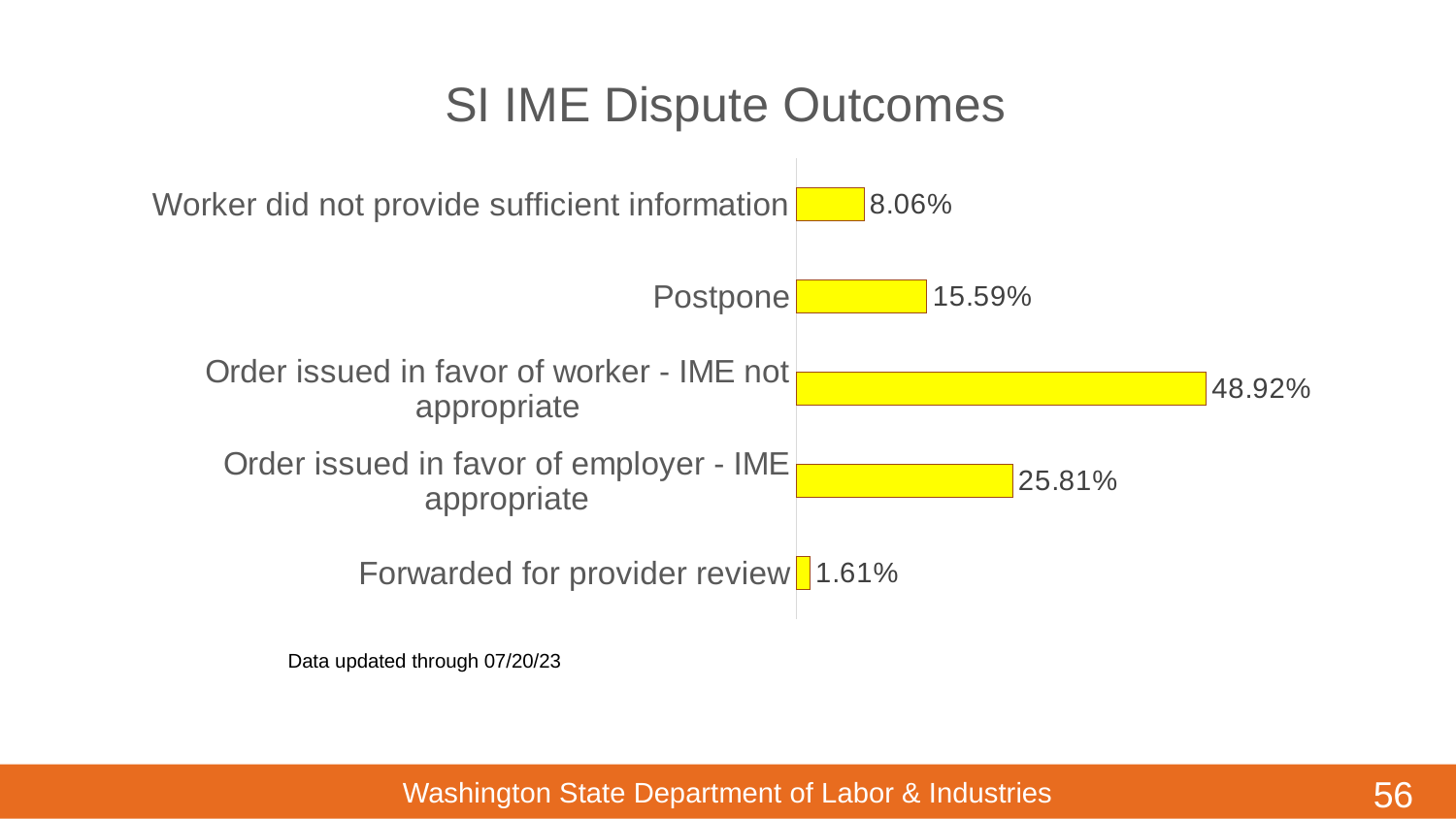
Which category has the lowest value? Forwarded for provider review What is the difference between "Order issued in favor of worker - IME not appropriate" and "Order issued in favor of employer - IME appropriate"? 23.11% Which is larger: "Postpone" or "Worker did not provide sufficient information"? Postpone What kind of chart is shown on the slide? Bar chart Which category has the highest value? Order issued in favor of worker - IME not appropriate What is the value for "Worker did not provide sufficient information"? 8.06% What is the value for "Postpone"? 15.59% What colour are the bars in the chart? Yellow How many categories are shown in the chart? 5 What is the difference between "Postpone" and "Worker did not provide sufficient information"? 7.53% What is the value for "Forwarded for provider review"? 1.61% What is the title of the chart? SI IME Dispute Outcomes